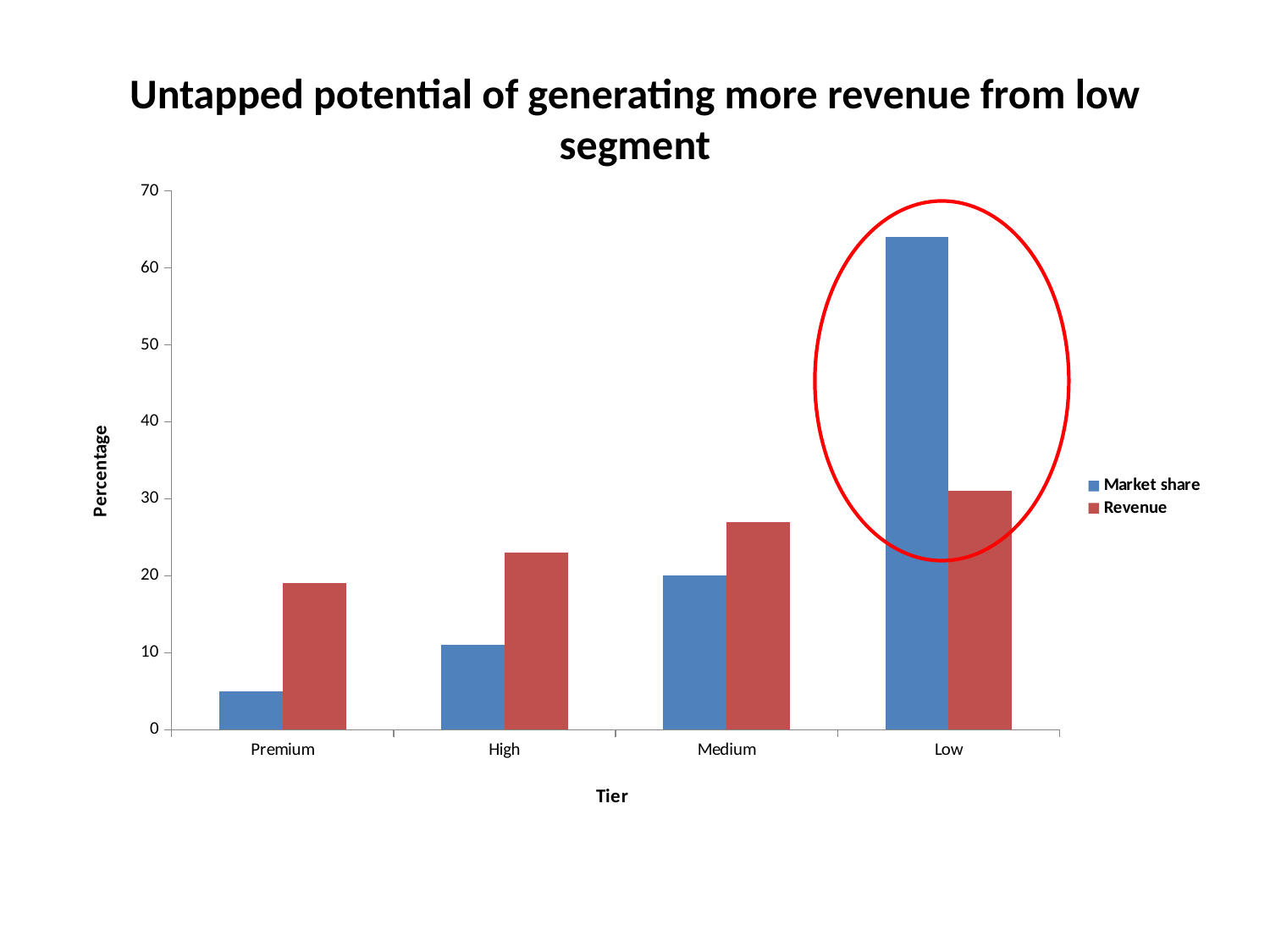
Which tier has the lowest Revenue? Premium Which tier has the lowest Market share? Premium How many tiers are shown on the x axis? 4 For the Low tier, which is larger, Market share or Revenue? Market share Which tier has the highest Market share? Low Which tier has the highest Revenue? Low Is the Revenue value for Premium greater or less than 20? less How many series does the legend list? 2 Is the Market share value for Low greater or less than 60? greater What kind of chart is shown on the slide? bar chart Do the Revenue values rise or fall from Premium to Low along the x axis? rise For the Premium tier, which is larger, Market share or Revenue? Revenue